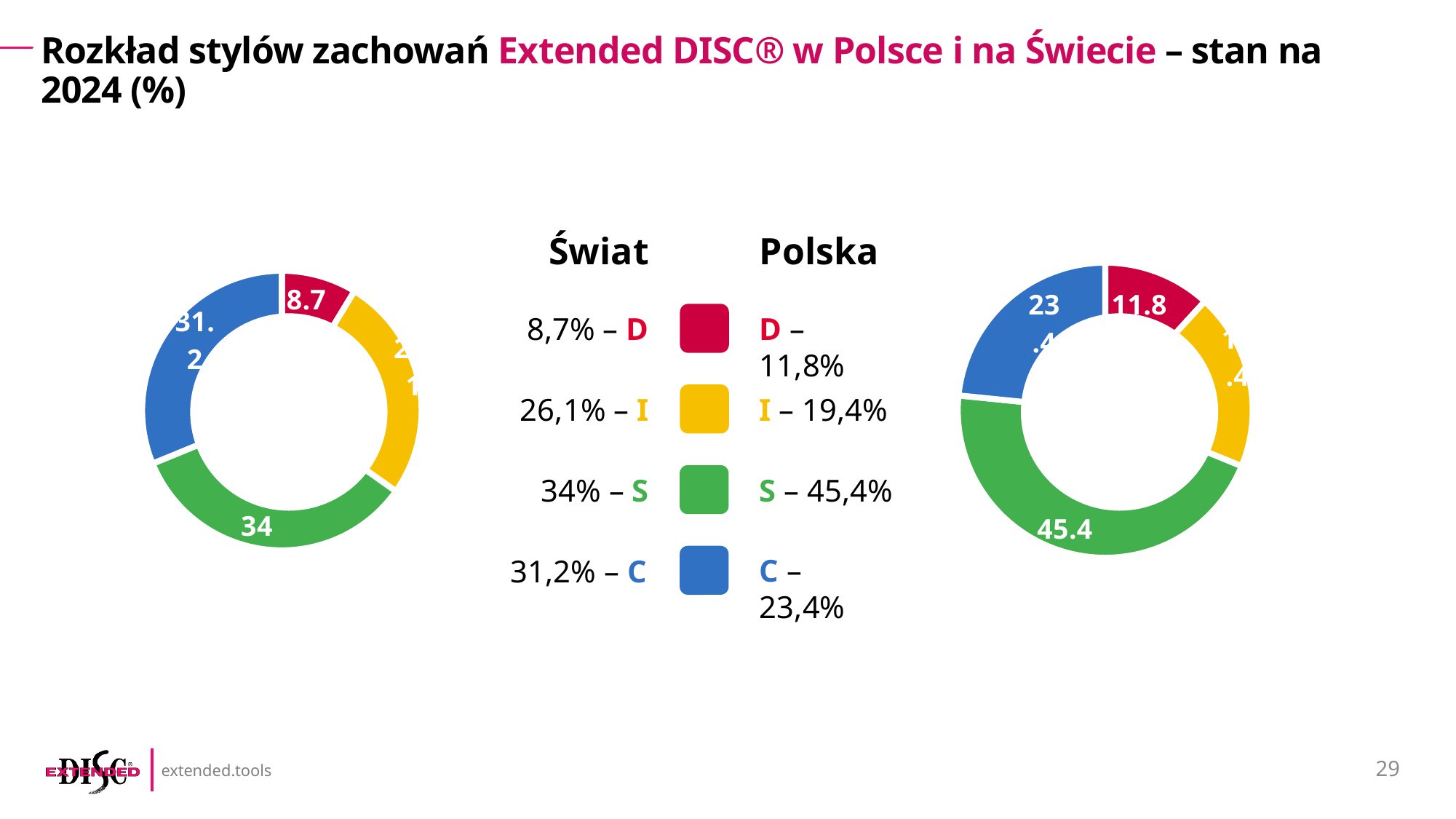
In the Świat chart, what share does style D have? 8,7% Which is larger: the share of style I in the Świat chart or in the Polska chart? Świat Which colour represents style C in the charts? Blue In the Świat chart, what share does style C have? 31,2% How many styles (slices) does each donut chart show? 4 What is the difference between the share of style D in Polska and in Świat? 3,1 percentage points In the Polska chart, what is the difference between the shares of S and C? 22 percentage points In the Polska chart, what share does style I have? 19,4% In the Polska chart, what share does style S have? 45,4% In the Świat chart, which style has the largest share? S What type of chart is used to show the Świat distribution on the left? Donut (pie) chart In the Polska chart, which style has the smallest share? D